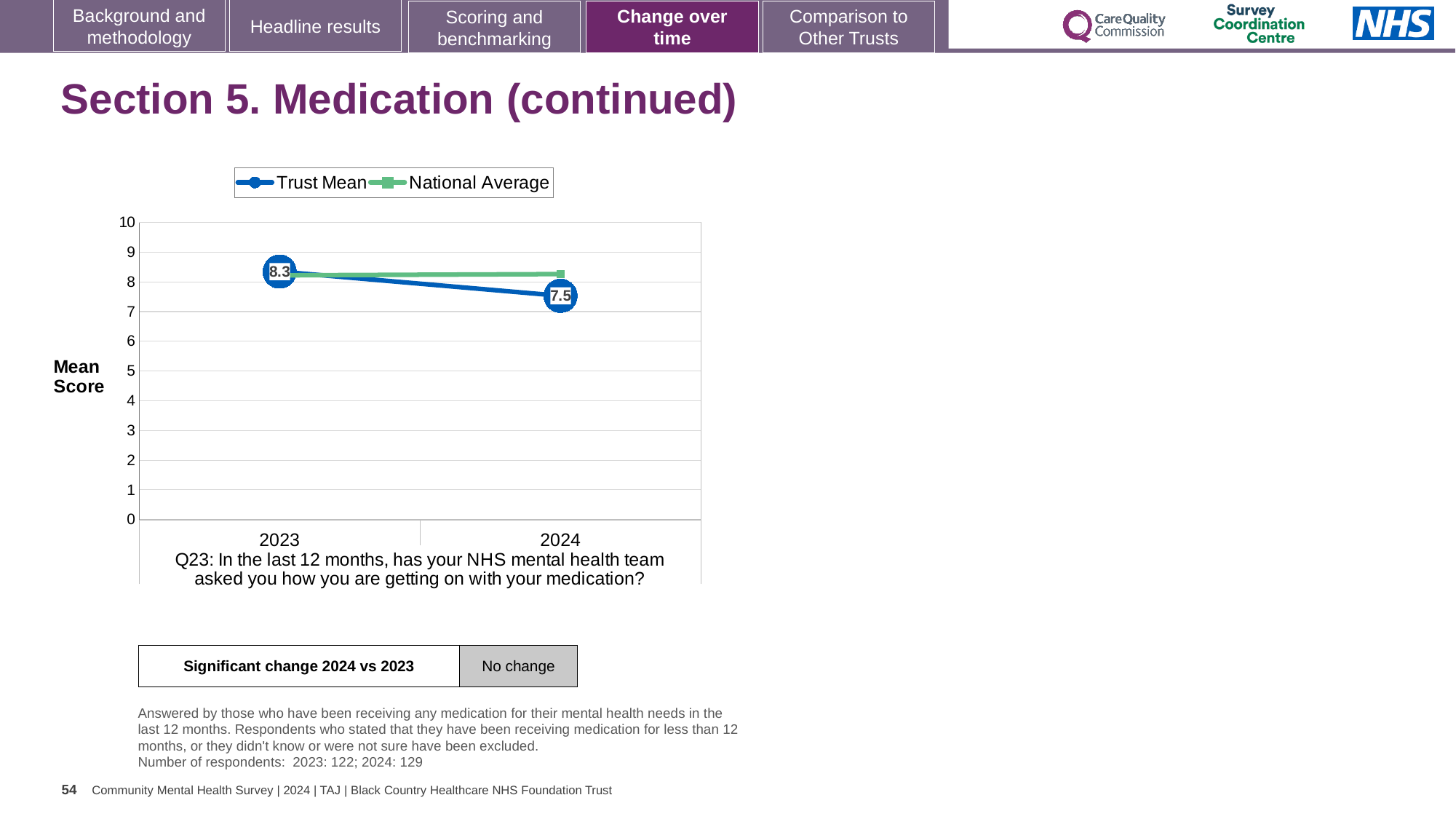
What is the Trust Mean value for 2023? 8.3 What is the Trust Mean value for 2024? 7.5 In which year is the Trust Mean highest? 2023 What kind of chart is shown on the slide? line chart How many series does the legend list? 2 How many years are plotted on the x axis? 2 What are the two series named in the legend? Trust Mean and National Average Is the National Average value for 2024 greater or less than 7? greater What is the label on the y axis? Mean Score In 2024, which is larger: the Trust Mean or the National Average? National Average By how much did the Trust Mean change from 2023 to 2024? 0.8 Does the Trust Mean rise or fall from 2023 to 2024? fall